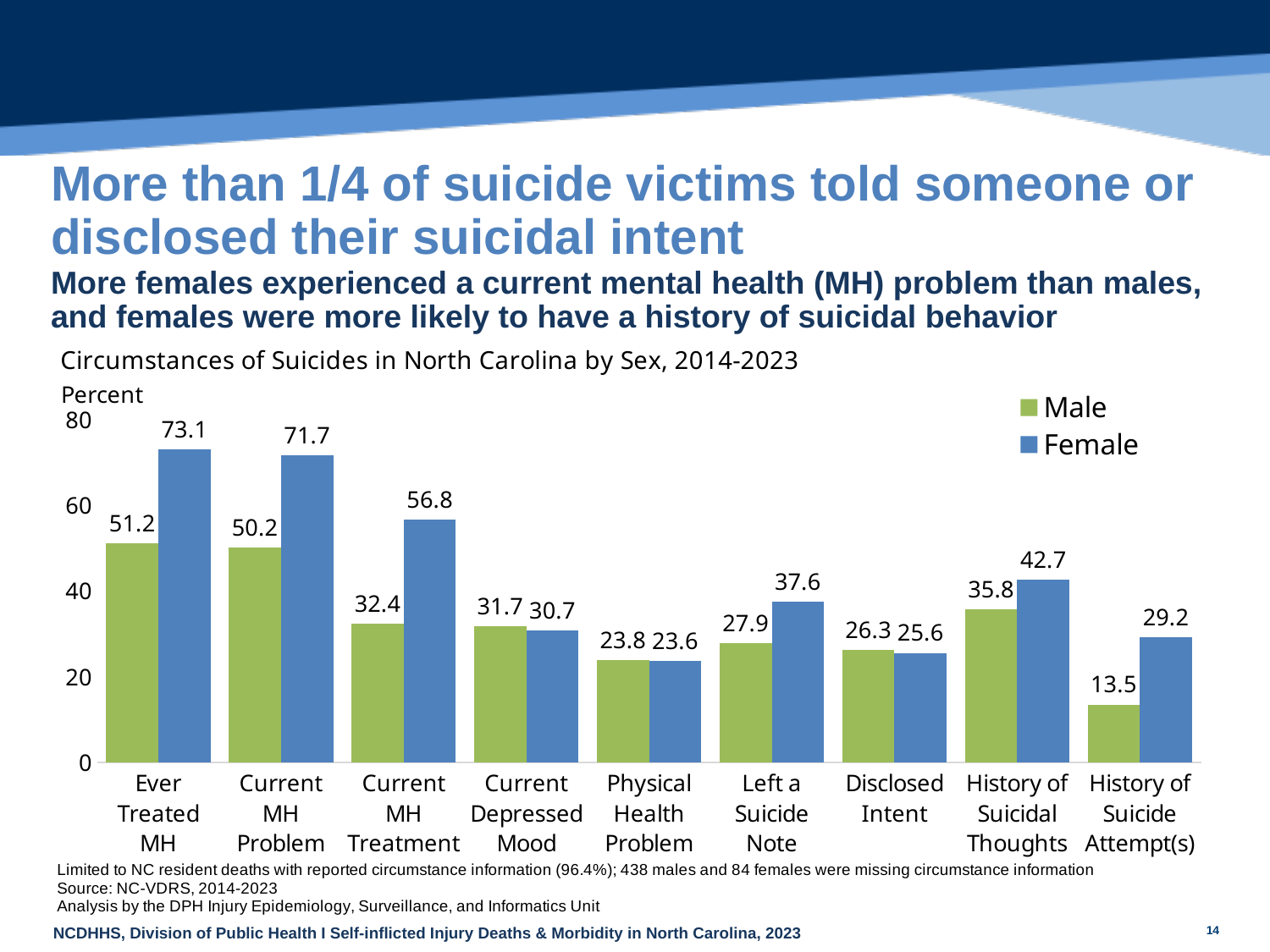
What is the title of the chart? Circumstances of Suicides in North Carolina by Sex, 2014-2023 What is the Male value for History of Suicide Attempt(s)? 13.5 Which category has the highest Female value? Ever Treated MH How many series does the legend list? 2 Which category has the lowest Male value? History of Suicide Attempt(s) How many circumstance categories are shown on the x axis? 9 Which is larger for Disclosed Intent, the Male value or the Female value? Male What is the difference between the Female and Male values for Current MH Treatment? 24.4 What kind of chart is shown? bar chart Is the Female value for History of Suicidal Thoughts greater or less than 40? greater What is the Female value for Ever Treated MH? 73.1 What is the Male value for Left a Suicide Note? 27.9